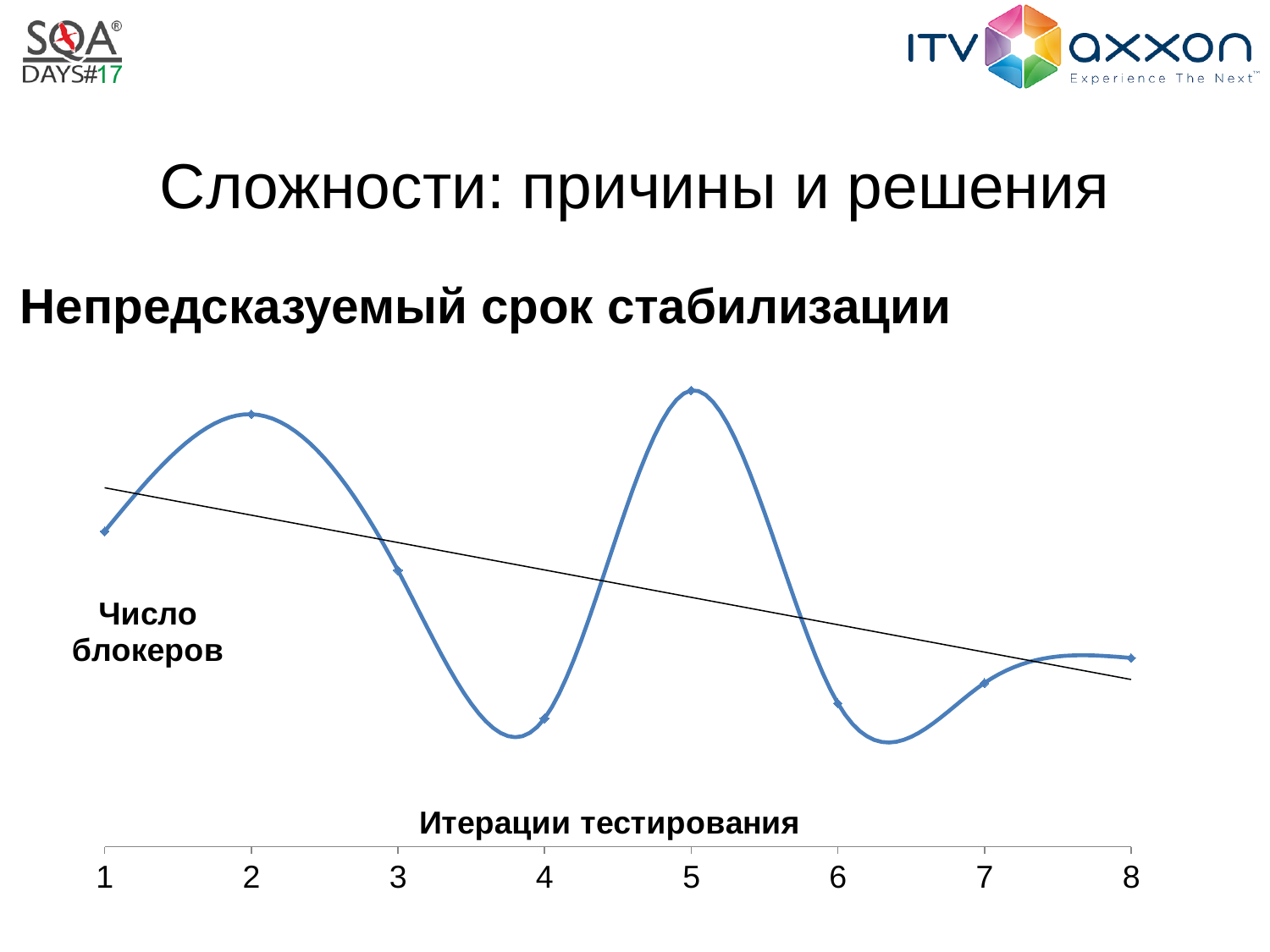
What kind of chart is shown on the slide? line chart What is the label of the x axis? Итерации тестирования What is the label of the y axis? Число блокеров How many testing iterations (points) are plotted along the x axis? 8 Does the number of blockers rise or fall from iteration 5 to iteration 6? fall Does the black straight trend line rise or fall from iteration 1 to iteration 8? fall Which iteration has more blockers, iteration 6 or iteration 8? 8 At which iteration is the number of blockers highest? 5 Which iteration has more blockers, iteration 2 or iteration 3? 2 Which iteration has fewer blockers, iteration 1 or iteration 7? 7 At which iteration is the number of blockers lowest? 4